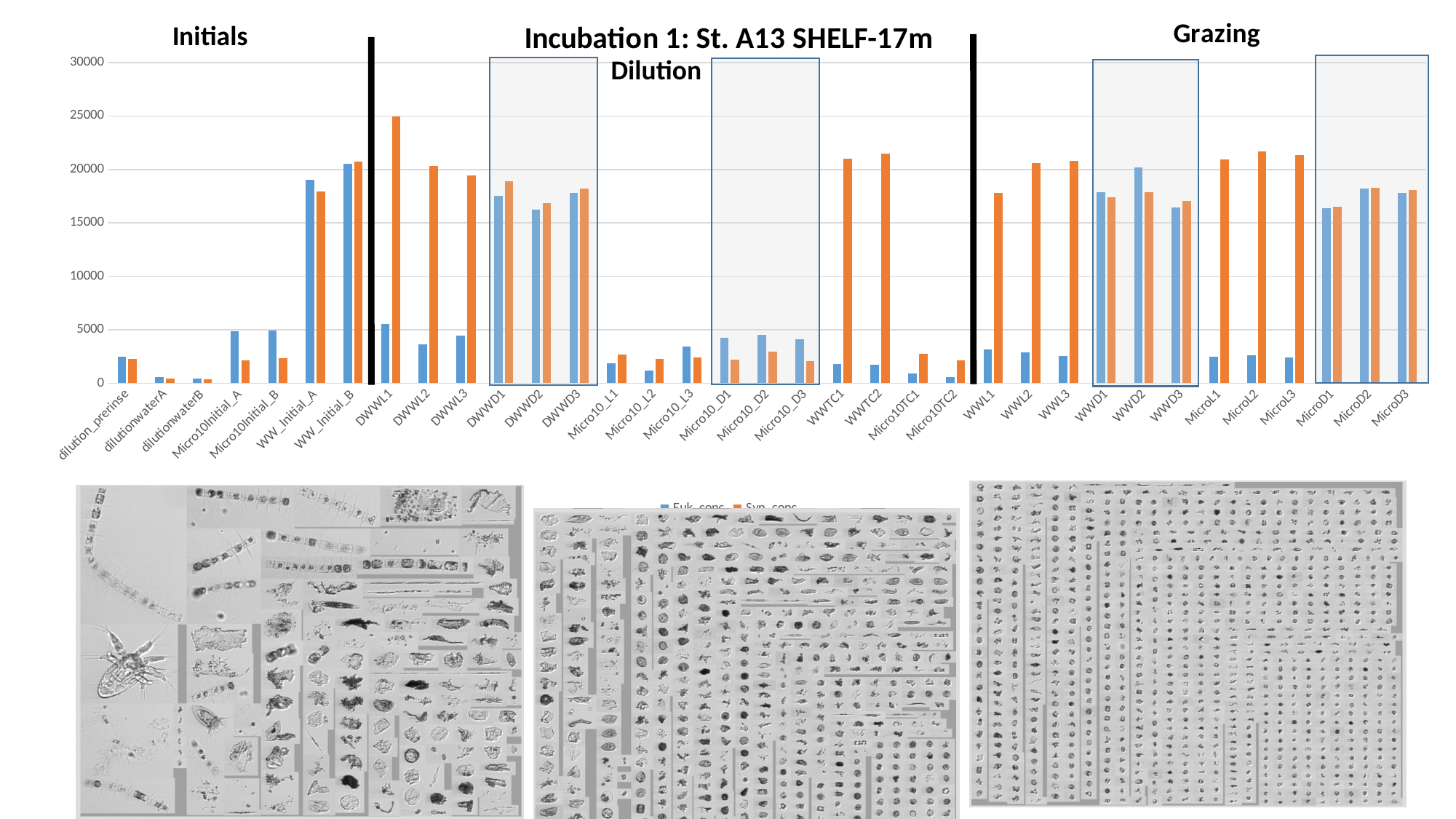
For DWWL1, which series has the larger value, the blue (Euk_conc) or the orange (Syn_conc)? orange (Syn_conc) Is the blue (Euk_conc) value for dilutionwaterA greater or less than 5000? less Which category has the highest orange (Syn_conc) bar? DWWL1 Is the blue (Euk_conc) value for DWWL1 greater or less than 10000? less What is the title of the chart? Incubation 1: St. A13 SHELF-17m What kind of chart is shown on the slide? bar chart Is the orange (Syn_conc) value for WWTC2 greater or less than 20000? greater For Micro10Initial_A, which series has the larger value, the blue (Euk_conc) or the orange (Syn_conc)? blue (Euk_conc) What are the three section labels written above the chart, from left to right? Initials, Dilution, Grazing How many series does the chart's legend list? 2 How many categories are shown along the x axis of the chart? 35